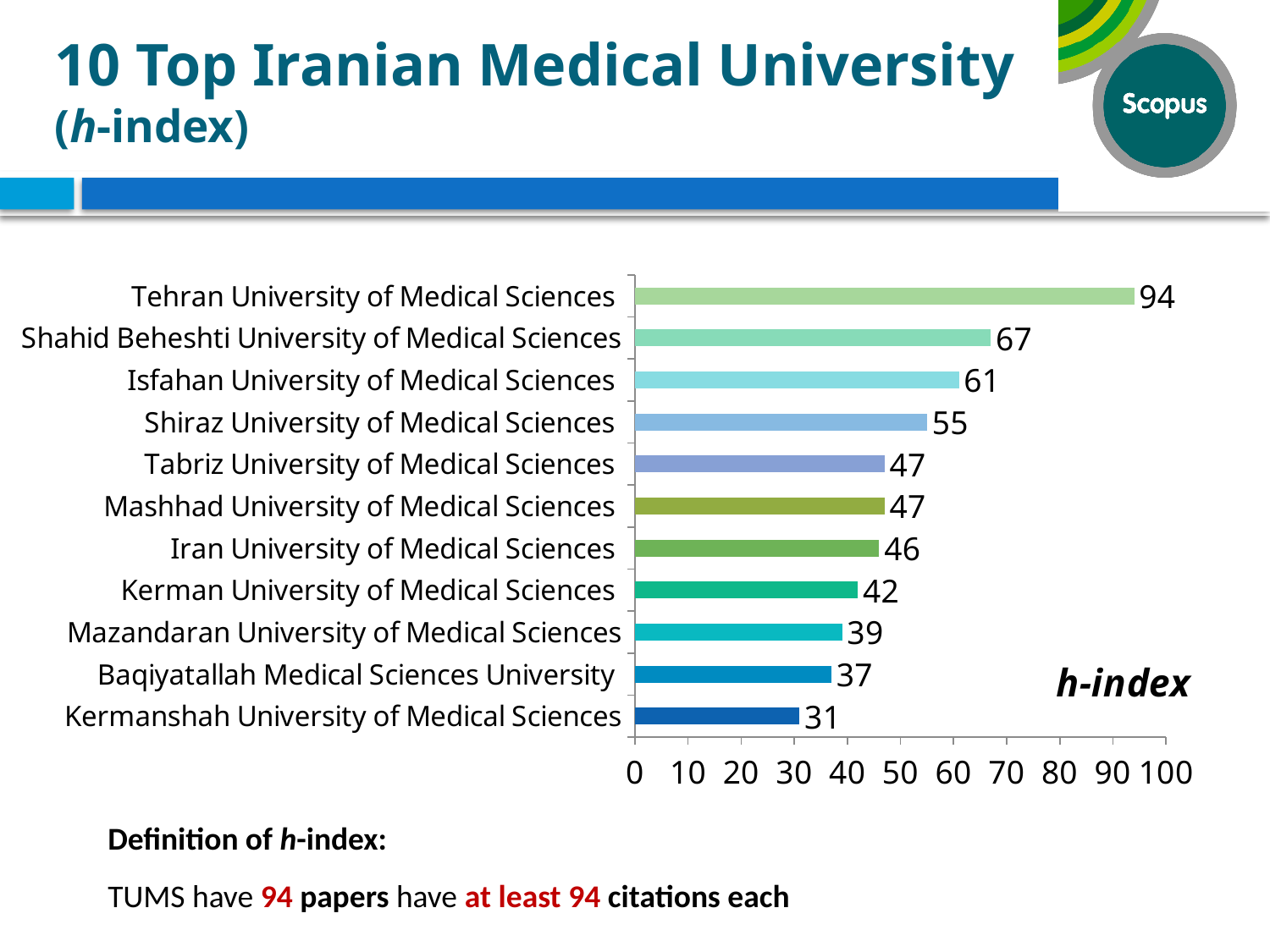
Which two universities share an h-index of 47? Tabriz University of Medical Sciences and Mashhad University of Medical Sciences What is the difference between the h-index of Tehran University of Medical Sciences and Shahid Beheshti University of Medical Sciences? 27 Which has a higher h-index, Isfahan University of Medical Sciences or Kerman University of Medical Sciences? Isfahan University of Medical Sciences Is the h-index value for Mazandaran University of Medical Sciences greater or less than 50? less What is the label shown inside the chart area near the bottom right? h-index What kind of chart is shown on the slide? bar chart Which university has the lowest h-index in the chart? Kermanshah University of Medical Sciences What is the h-index value for Shiraz University of Medical Sciences? 55 Which university has the highest h-index in the chart? Tehran University of Medical Sciences What is the h-index value for Tehran University of Medical Sciences? 94 How many universities are shown in the chart? 11 What is the h-index value for Baqiyatallah Medical Sciences University? 37